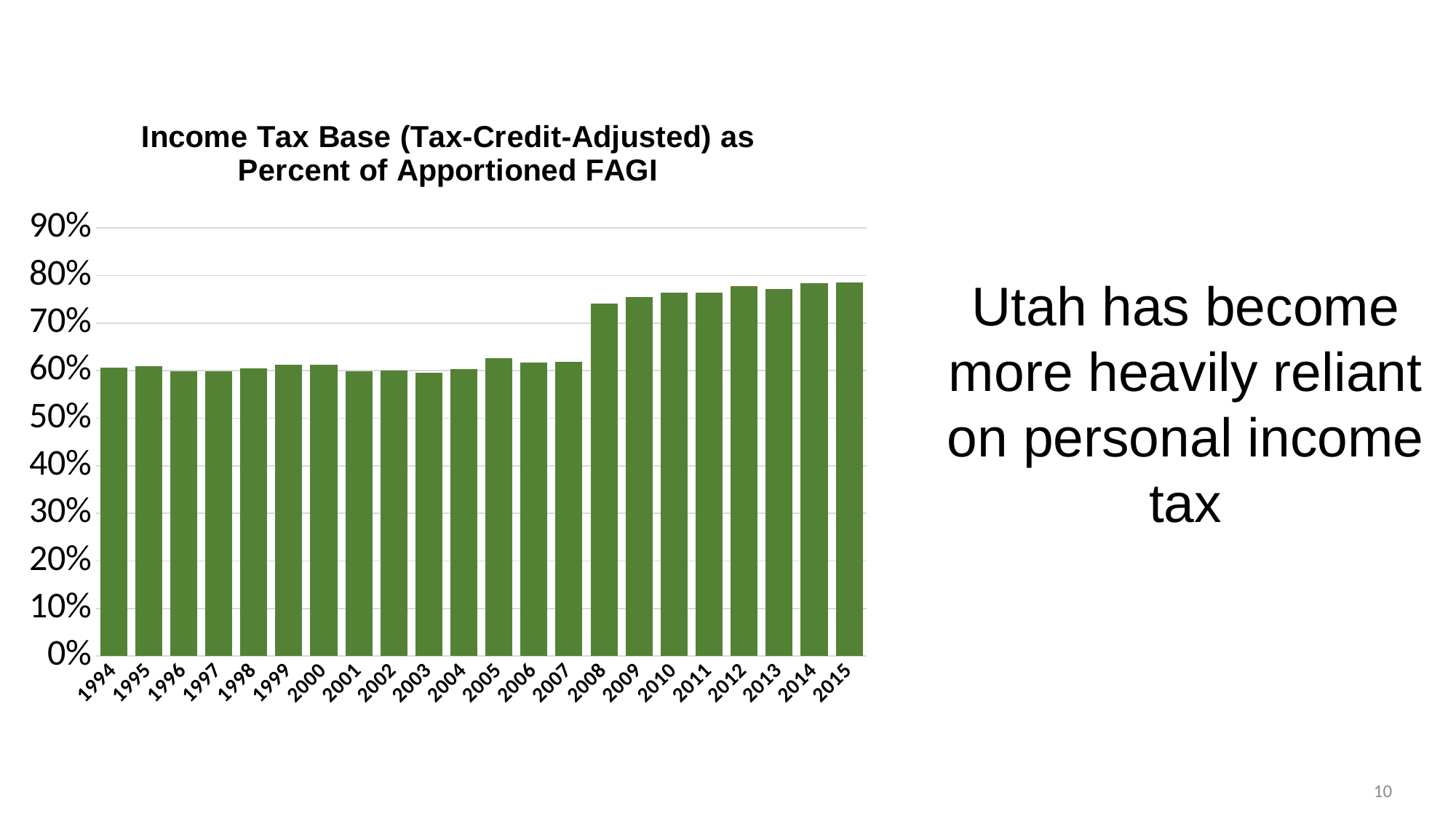
Is the value for 2003 greater or less than 70%? less Which year has the larger value, 2007 or 2008? 2008 Is the value for 2005 greater or less than 60%? greater Is the value for 2015 greater or less than 80%? less What kind of chart is shown on the slide? bar chart Which year has the larger value, 1994 or 2015? 2015 How many years are shown on the x axis of the chart? 22 Overall, do the values rise or fall from 1994 to 2015? rise What is the first year shown on the x axis? 1994 What is the title of the chart? Income Tax Base (Tax-Credit-Adjusted) as Percent of Apportioned FAGI